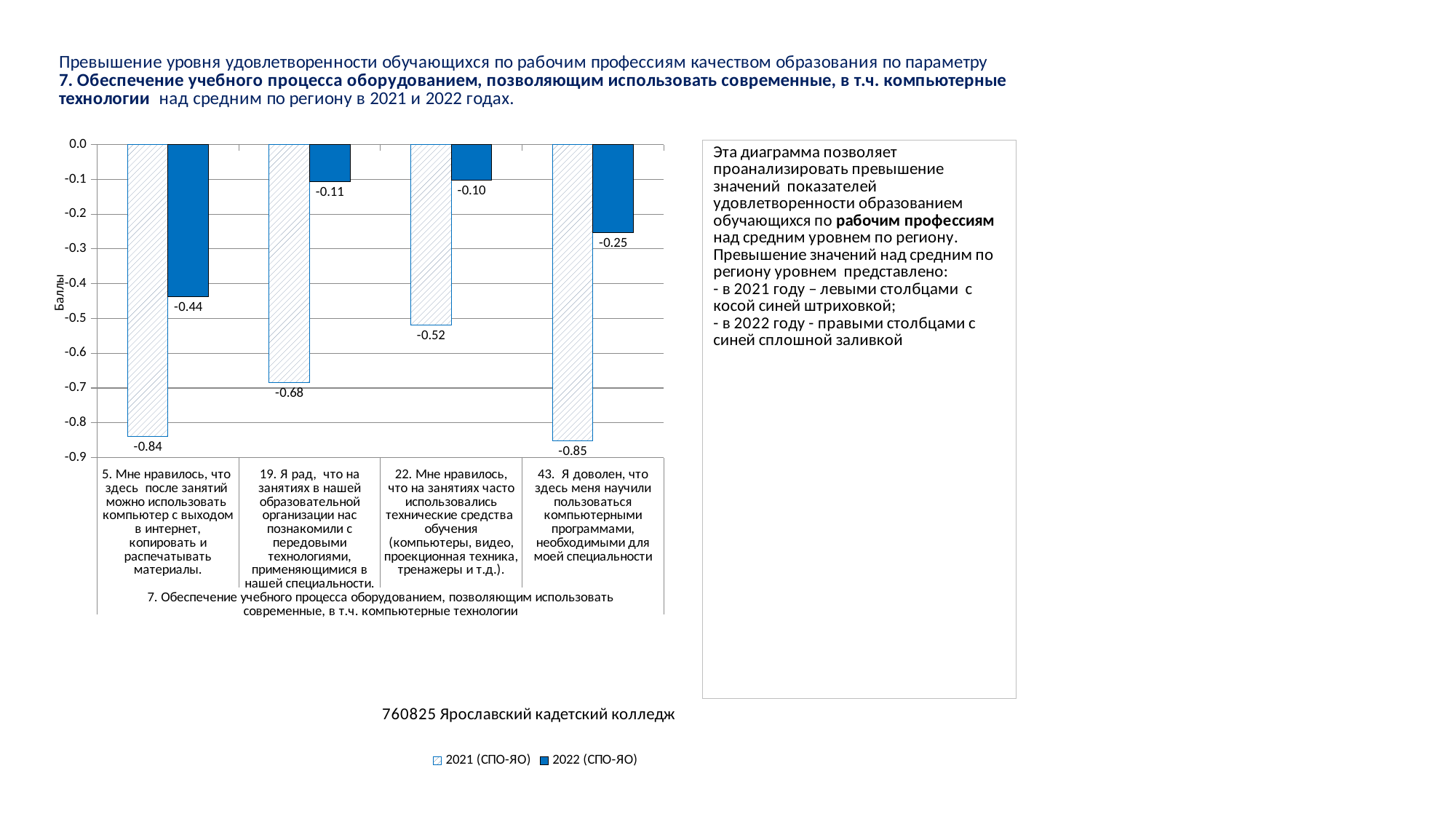
How many statements (categories) are shown on the x axis of the chart? 4 What is the difference between the 2022 and 2021 values for statement 5? 0.40 What is the label of the vertical axis of the chart? Баллы What is the 2022 (СПО-ЯО) value for statement 43 (taught to use computer programs needed for the specialty)? -0.25 For statement 43, which series has the larger value, 2021 (СПО-ЯО) or 2022 (СПО-ЯО)? 2022 (СПО-ЯО) What is the 2022 (СПО-ЯО) value for statement 19 (being introduced to advanced technologies)? -0.11 Is the 2021 (СПО-ЯО) value for statement 19 greater or less than -0.6? less Which statement has the lowest 2022 (СПО-ЯО) value? 5. Мне нравилось, что здесь после занятий можно использовать компьютер с выходом в интернет, копировать и распечатывать материалы. What is the 2021 (СПО-ЯО) value for statement 22 (technical teaching aids used often in classes)? -0.52 What is the 2021 (СПО-ЯО) value for statement 5 (using a computer with internet access after classes)? -0.84 Which statement has the highest 2021 (СПО-ЯО) value? 22. Мне нравилось, что на занятиях часто использовались технические средства обучения (компьютеры, видео, проекционная техника, тренажеры и т.д.). How many series does the chart legend list? 2